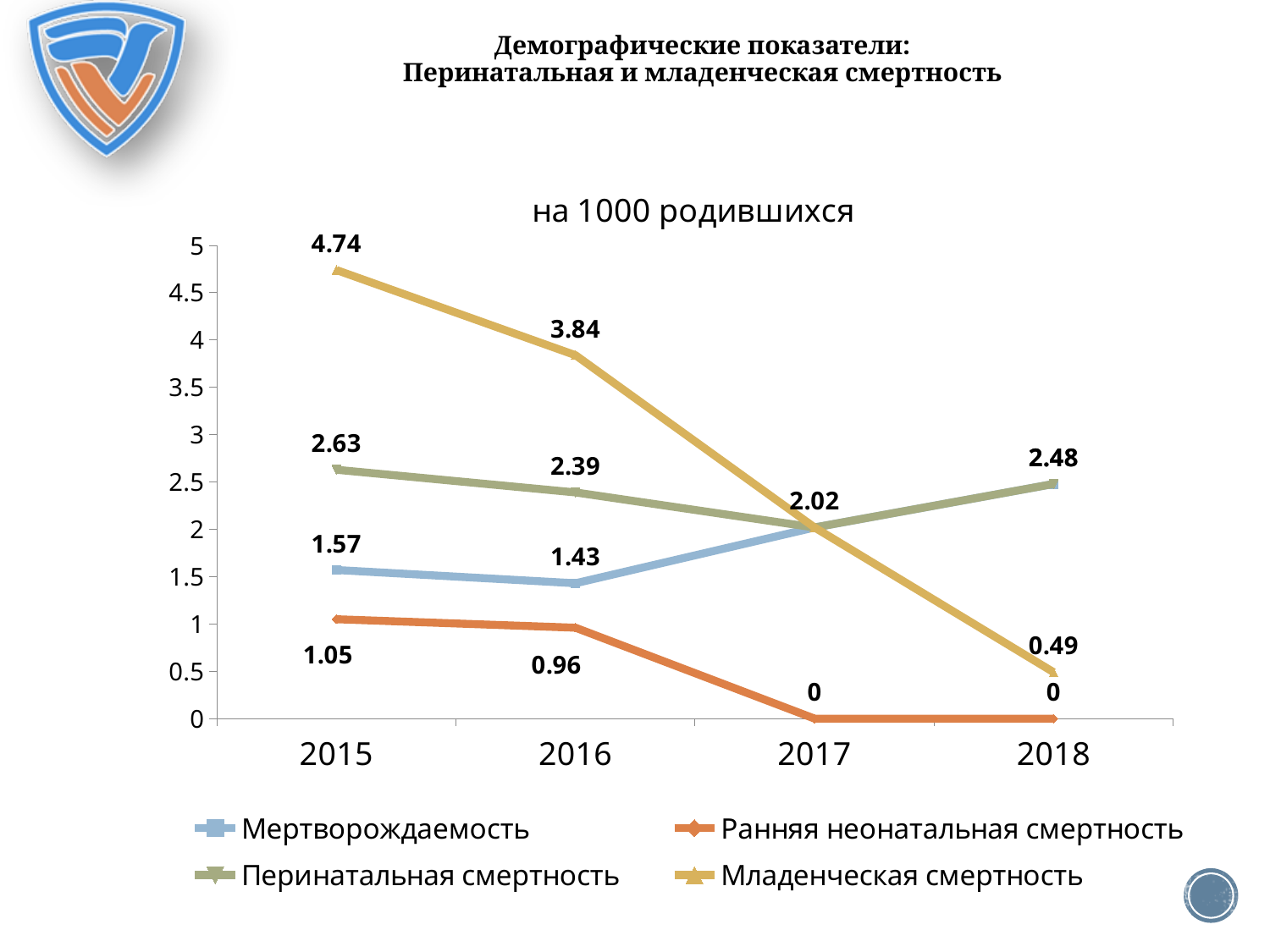
Which series has the highest value in 2015? Младенческая смертность What is the value for Младенческая смертность in 2018? 0.49 Which is larger in 2016: Перинатальная смертность or Мертворождаемость? Перинатальная смертность By how much did Младенческая смертность fall from 2015 to 2016? 0.90 What is the value for Младенческая смертность in 2015? 4.74 Does Младенческая смертность rise or fall from 2015 to 2018? fall How many series does the legend list? 4 Is the value for Младенческая смертность in 2017 greater or less than 3? less What is the value for Мертворождаемость in 2015? 1.57 What is the value for Ранняя неонатальная смертность in 2017? 0 What kind of chart is shown on the slide? line chart What is the value for Перинатальная смертность in 2016? 2.39